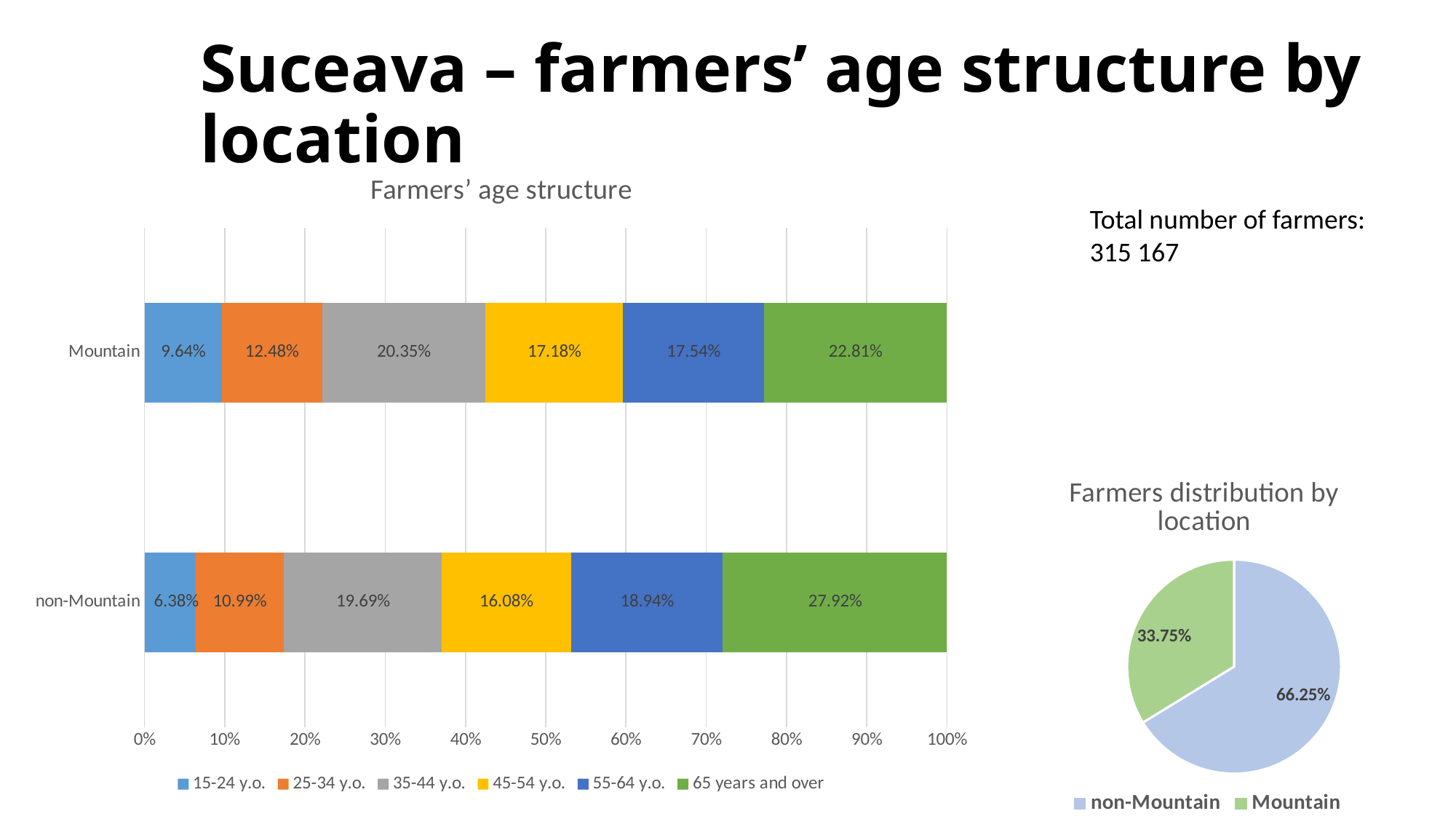
In the 'Farmers' age structure' chart, which age group has the largest share for Mountain? 65 years and over In the 'Farmers' age structure' chart, which location has the larger value for the 55-64 y.o. series? non-Mountain What kind of chart is 'Farmers distribution by location'? Pie chart How many series does the legend of the 'Farmers' age structure' chart list? 6 What kind of chart is 'Farmers' age structure'? Stacked bar chart In the 'Farmers' age structure' chart, which age group has the smallest share for non-Mountain? 15-24 y.o. In the 'Farmers distribution by location' pie chart, which slice is larger? non-Mountain In the 'Farmers' age structure' chart, what is the difference between the 65 years and over values for non-Mountain and Mountain? 5.11% In the 'Farmers' age structure' chart, what is the value for the 65 years and over series for non-Mountain? 27.92% In the 'Farmers' age structure' chart, what is the value for the 35-44 y.o. series for Mountain? 20.35% In the 'Farmers' age structure' chart, what is the value for the 15-24 y.o. series for non-Mountain? 6.38% In the 'Farmers distribution by location' pie chart, what is the share for Mountain? 33.75%